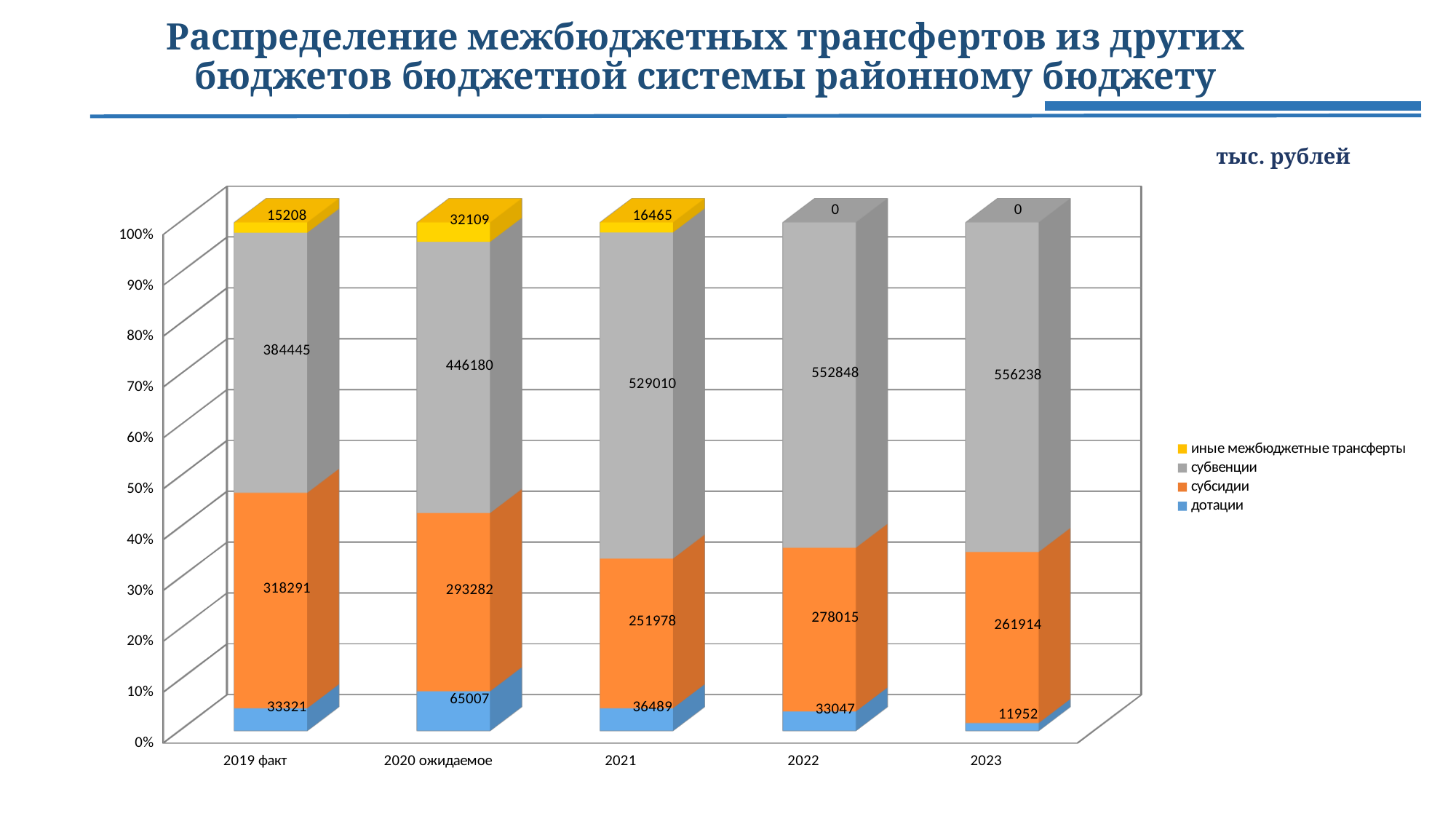
What kind of chart is shown on the slide? Stacked bar chart Which is larger: иные межбюджетные трансферты in 2020 ожидаемое or in 2021? 2020 ожидаемое What is the value of субвенции for 2021? 529010 What is the total of the stacked bar for 2022? 863910 How many categories are shown on the x axis? 5 Which category has the highest value for субвенции? 2023 How many series does the legend list? 4 Which category has the lowest value for дотации? 2023 What is the value of субсидии for 2023? 261914 What is the difference between субсидии in 2019 факт and 2020 ожидаемое? 25009 What is the value of иные межбюджетные трансферты for 2022? 0 What is the value of дотации for 2020 ожидаемое? 65007